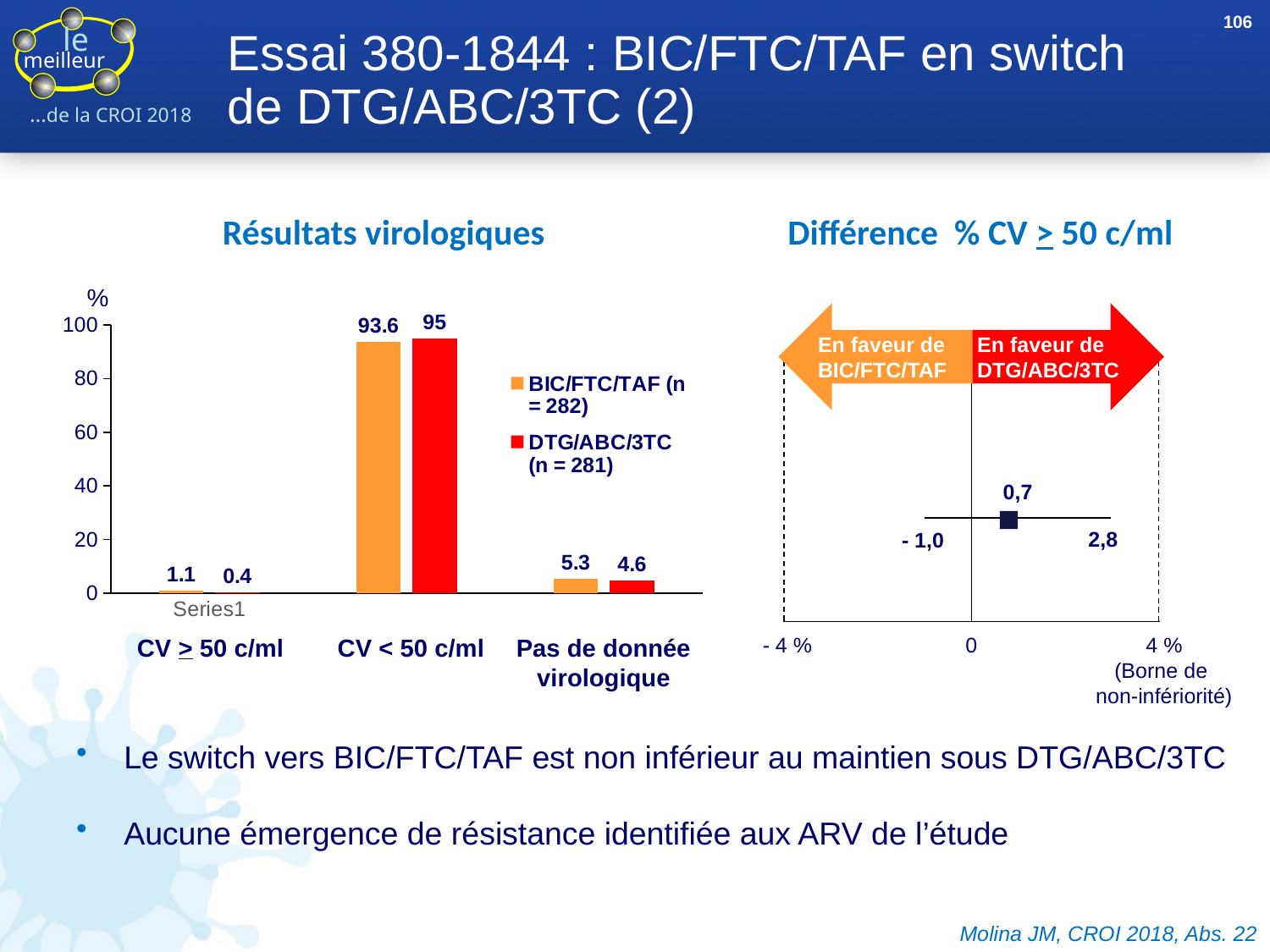
In the 'Résultats virologiques' chart, which category has the lowest value for DTG/ABC/3TC? CV ≥ 50 c/ml In the 'Résultats virologiques' chart, what is the value for BIC/FTC/TAF in the CV ≥ 50 c/ml category? 1.1 In the 'Résultats virologiques' chart, what is the value for DTG/ABC/3TC in the CV < 50 c/ml category? 95 In the 'Résultats virologiques' chart, which series has the larger value in the 'Pas de donnée virologique' category? BIC/FTC/TAF What kind of chart is the 'Résultats virologiques' chart? bar chart How many series does the legend of the 'Résultats virologiques' chart list? 2 In the 'Résultats virologiques' chart, what is the value for DTG/ABC/3TC in the 'Pas de donnée virologique' category? 4.6 In the 'Résultats virologiques' chart, what is the difference between the DTG/ABC/3TC and BIC/FTC/TAF values in the CV < 50 c/ml category? 1.4 In the 'Différence % CV ≥ 50 c/ml' chart, what is the point estimate shown above the square marker? 0,7 In the 'Résultats virologiques' chart, is the value for BIC/FTC/TAF in the CV < 50 c/ml category greater or less than 80? greater In the 'Résultats virologiques' chart, what is the value for BIC/FTC/TAF in the CV < 50 c/ml category? 93.6 In the 'Résultats virologiques' chart, which category has the highest values for both series? CV < 50 c/ml